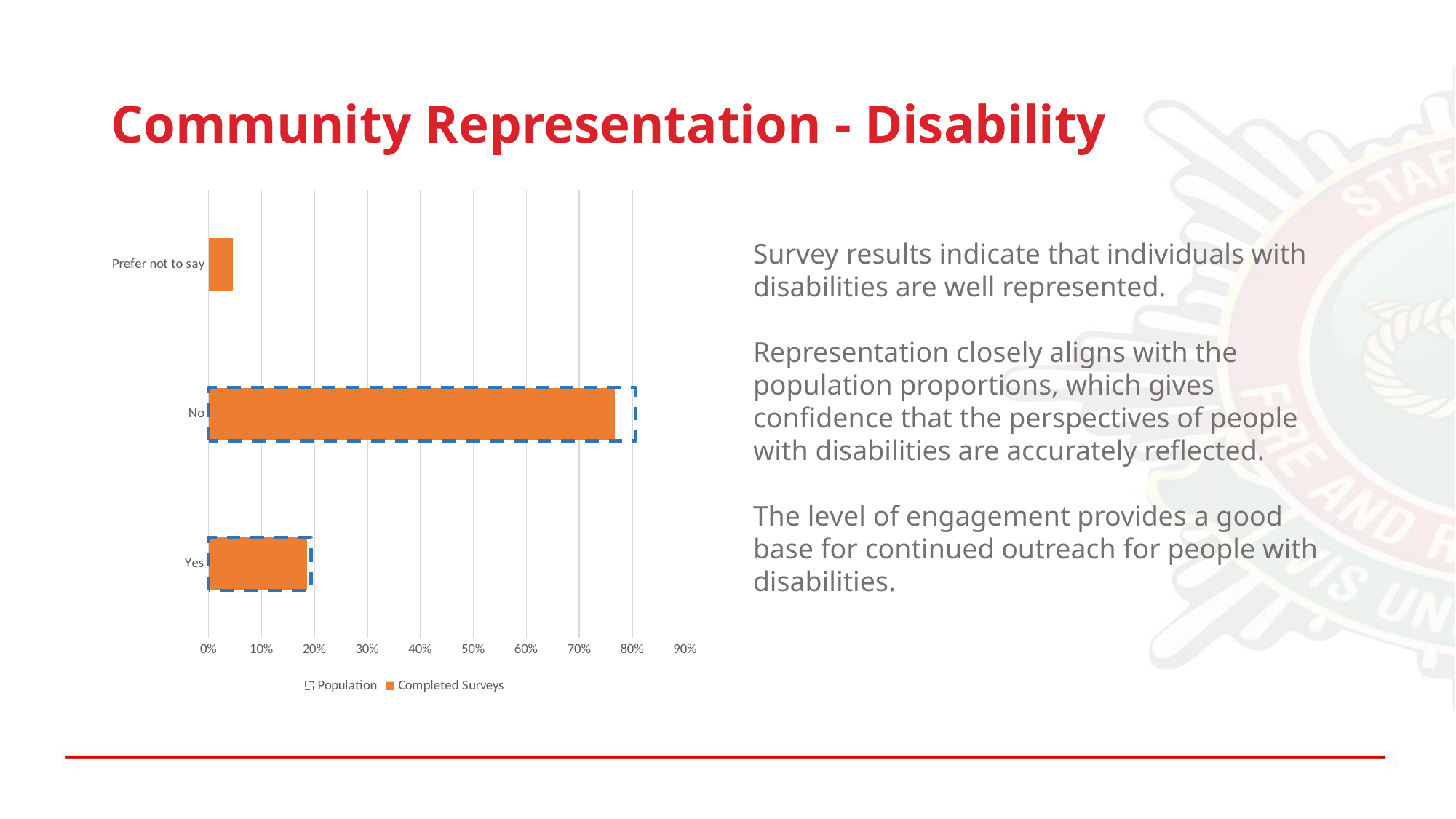
What kind of chart is shown on the slide? Bar chart Is the Completed Surveys value for Yes greater or less than 20%? less Which category has the lowest Completed Surveys value? Prefer not to say Which series is shown with a dashed outline in the legend? Population How many series does the chart's legend list? 2 Is the Completed Surveys value for No greater or less than 70%? greater Which is larger: the Completed Surveys value for Yes or for Prefer not to say? Yes What colour are the Completed Surveys bars? Orange How many categories are shown on the chart? 3 Which category has the highest Completed Surveys value? No Is the Completed Surveys value for Prefer not to say greater or less than 10%? less